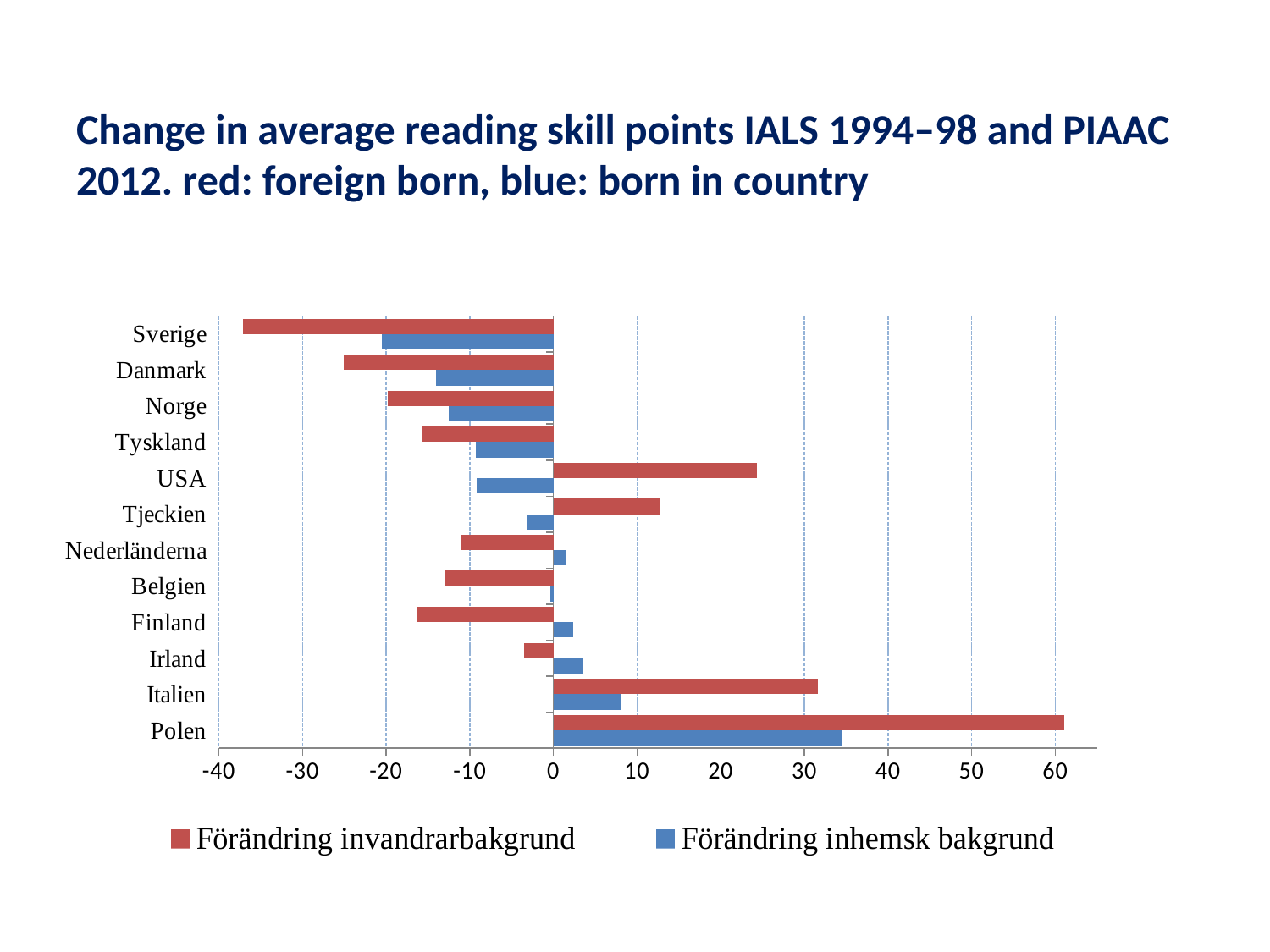
Is the Förändring invandrarbakgrund (red) value for Sverige greater or less than -30? less How many countries are listed on the vertical axis of the chart? 12 Which country has the highest value for Förändring invandrarbakgrund (red)? Polen Which country has the lowest value for Förändring inhemsk bakgrund (blue)? Sverige How many series does the legend list? 2 Which country has the highest value for Förändring inhemsk bakgrund (blue)? Polen Is the Förändring invandrarbakgrund (red) value for USA greater or less than 20? greater Which country has the lowest value for Förändring invandrarbakgrund (red)? Sverige What kind of chart is shown on the slide? bar chart Which has the larger Förändring invandrarbakgrund (red) value, Italien or USA? Italien Is the Förändring invandrarbakgrund (red) value for Polen greater or less than 50? greater What are the two legend entries of the chart? Förändring invandrarbakgrund and Förändring inhemsk bakgrund